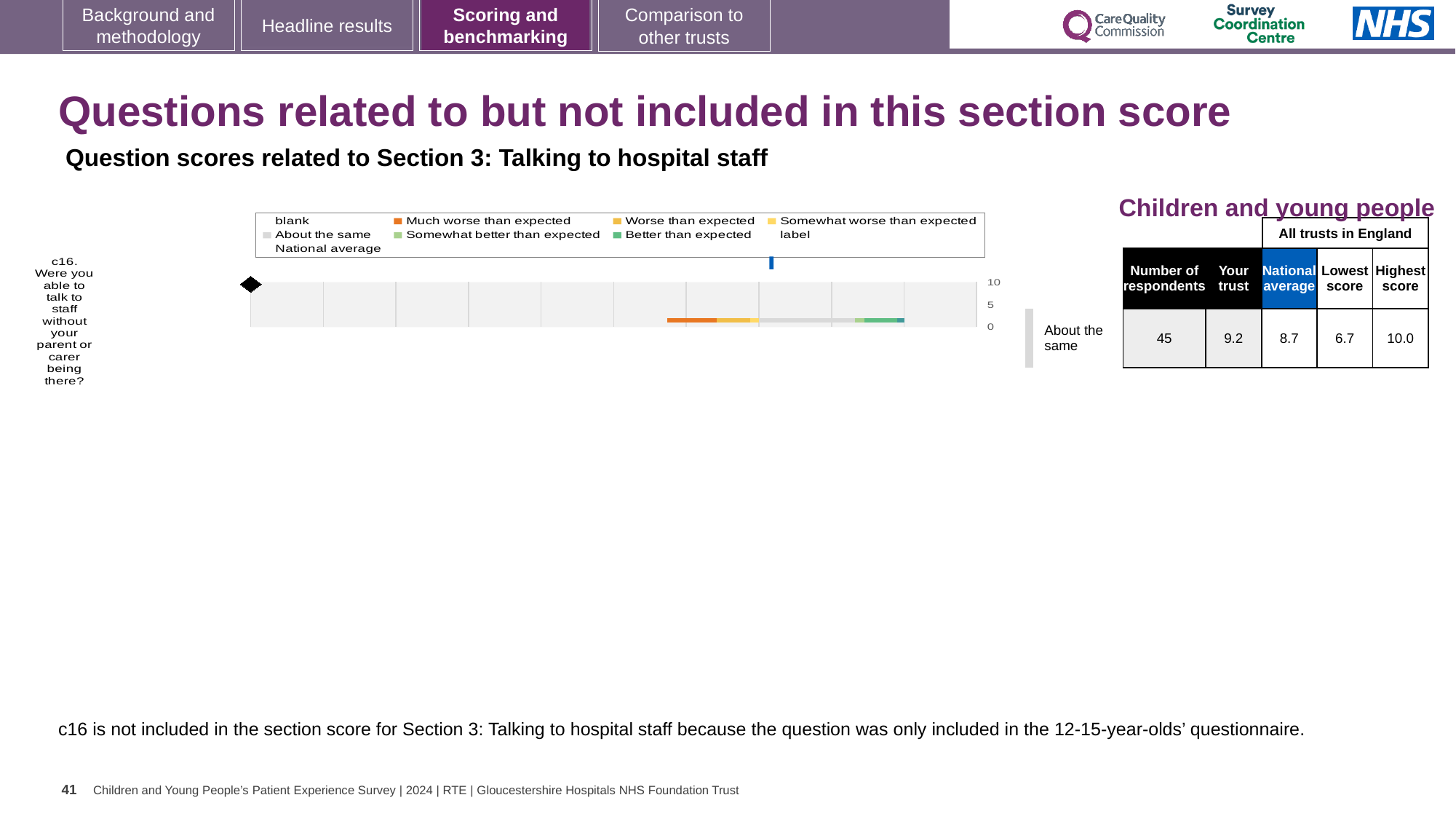
In the table beside the chart, what is the difference between the 'Your trust' score and the national average for c16? 0.5 In the table beside the chart, what is the number of respondents for c16? 45 What rating category is shown for question c16 next to the chart? About the same What is the highest value shown on the chart's axis? 10 In the table beside the chart, what is the difference between the highest score and the lowest score for c16? 3.3 How many survey questions are plotted in the chart? 1 In the table beside the chart, what is the national average score for c16? 8.7 What colour does the legend use for 'Much worse than expected'? orange In the table beside the chart, what is the 'Your trust' score for c16? 9.2 In the table beside the chart, which is larger for c16: the 'Your trust' score or the national average? Your trust What kind of chart is shown for question c16? bar chart In the table beside the chart, what is the lowest score among all trusts in England for c16? 6.7